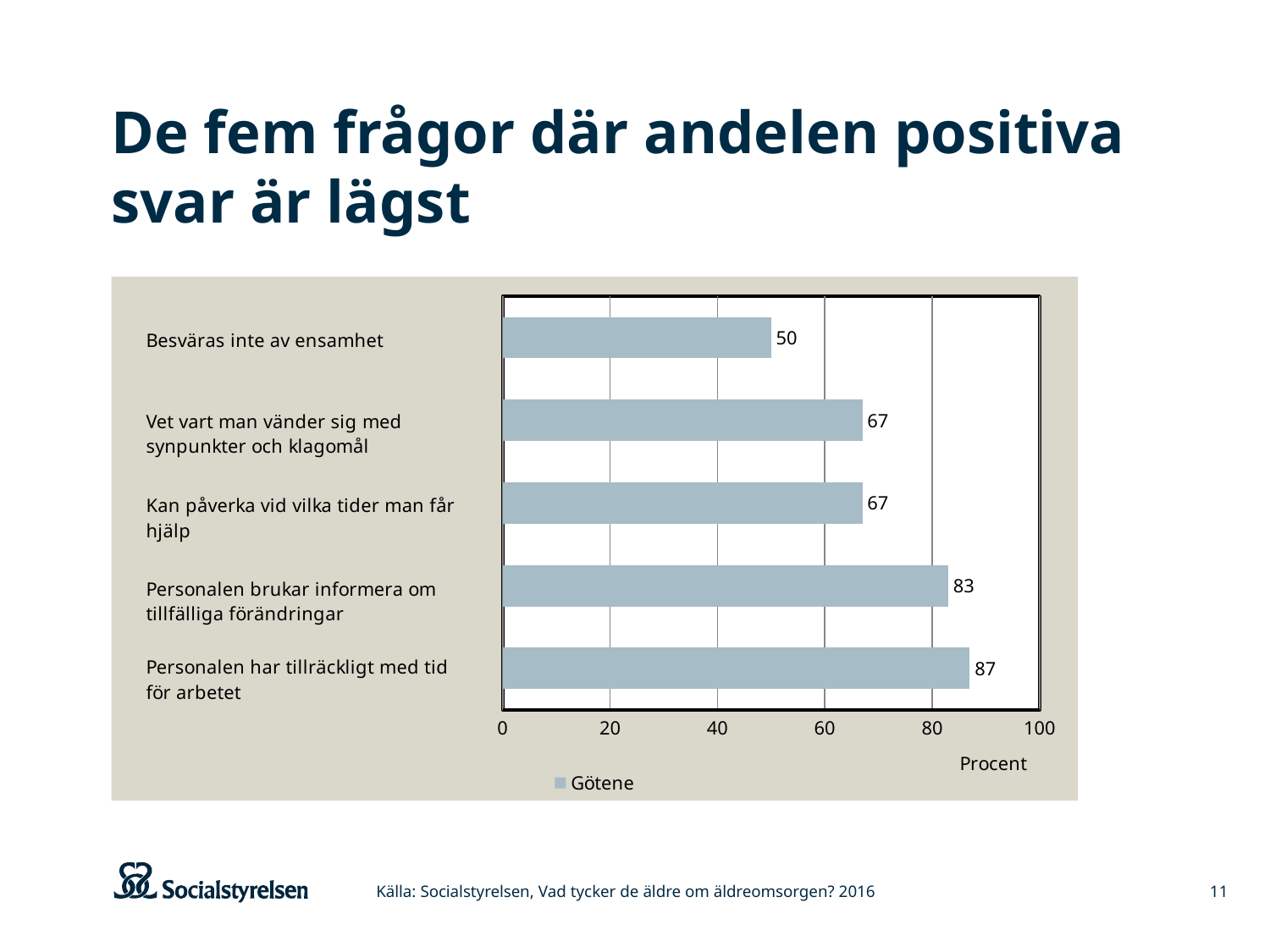
What kind of chart is shown on the slide? bar chart Which is larger: the value for "Personalen brukar informera om tillfälliga förändringar" or the value for "Vet vart man vänder sig med synpunkter och klagomål"? Personalen brukar informera om tillfälliga förändringar Is the value for "Besväras inte av ensamhet" greater or less than 60? less How many categories are shown in the chart? 5 What is the value for "Kan påverka vid vilka tider man får hjälp"? 67 How many series does the legend list? 1 Which category has the highest value? Personalen har tillräckligt med tid för arbetet What is the difference between the values for "Personalen har tillräckligt med tid för arbetet" and "Besväras inte av ensamhet"? 37 Which category has the lowest value? Besväras inte av ensamhet What is the value for "Personalen har tillräckligt med tid för arbetet"? 87 What is the value for "Personalen brukar informera om tillfälliga förändringar"? 83 What is the value for "Besväras inte av ensamhet"? 50